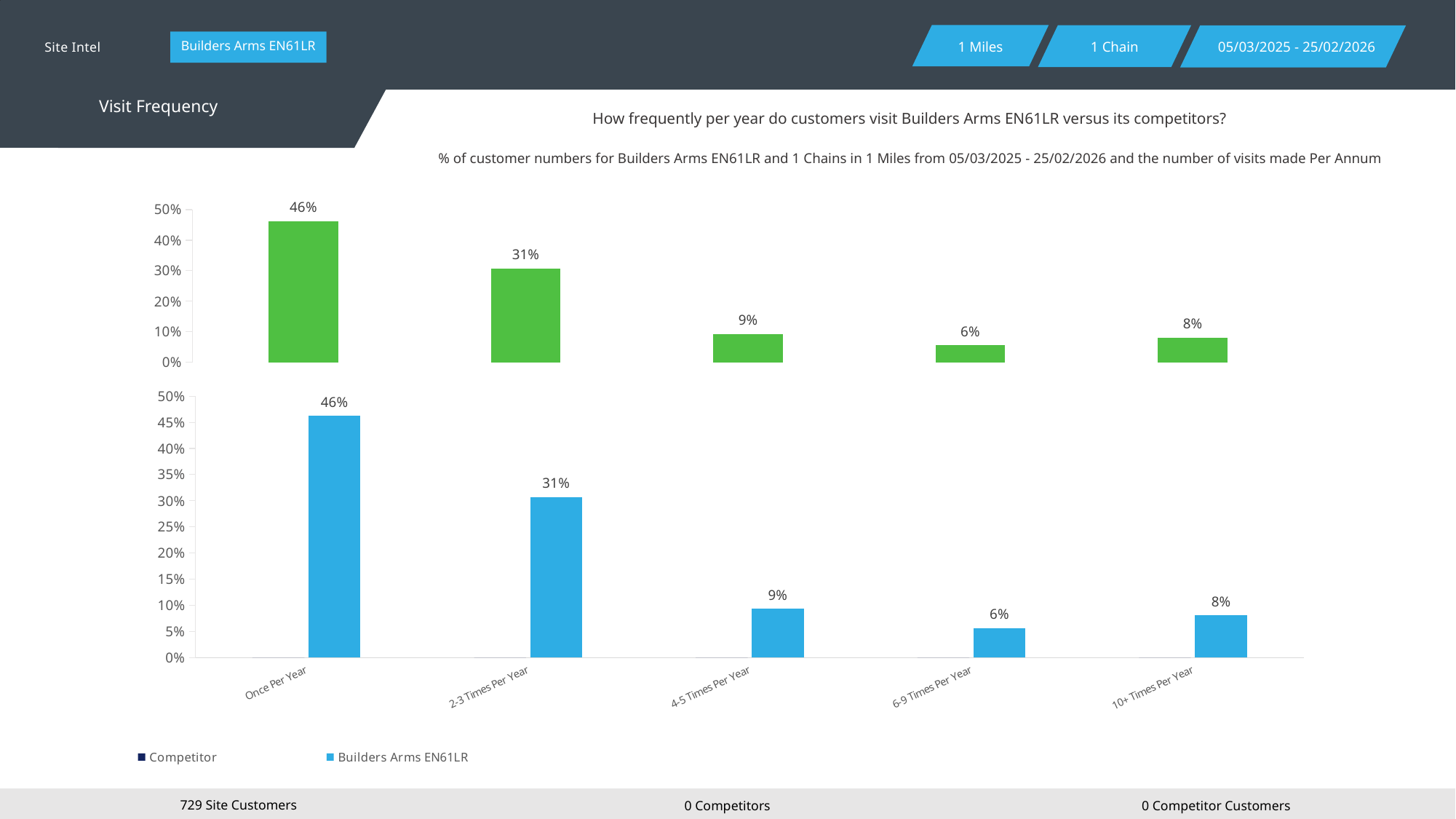
In the bottom chart, which category has the lowest value for Builders Arms EN61LR? 6-9 Times Per Year In the bottom chart, which is larger for Builders Arms EN61LR: 4-5 Times Per Year or 6-9 Times Per Year? 4-5 Times Per Year In the bottom chart, what is the value for Builders Arms EN61LR for 2-3 Times Per Year? 31% What type of chart is the top chart? Bar chart In the bottom chart, what is the value for Builders Arms EN61LR for 10+ Times Per Year? 8% In the bottom chart, what is the value for Builders Arms EN61LR for Once Per Year? 46% In the bottom chart, what is the difference between the Builders Arms EN61LR values for Once Per Year and 2-3 Times Per Year? 15% How many categories are shown on the x axis of the bottom chart? 5 How many series does the legend of the bottom chart list? 2 In the bottom chart, which category has the highest value for Builders Arms EN61LR? Once Per Year What is the highest value labelled in the top chart? 46% In the bottom chart, what is the value for Builders Arms EN61LR for 4-5 Times Per Year? 9%